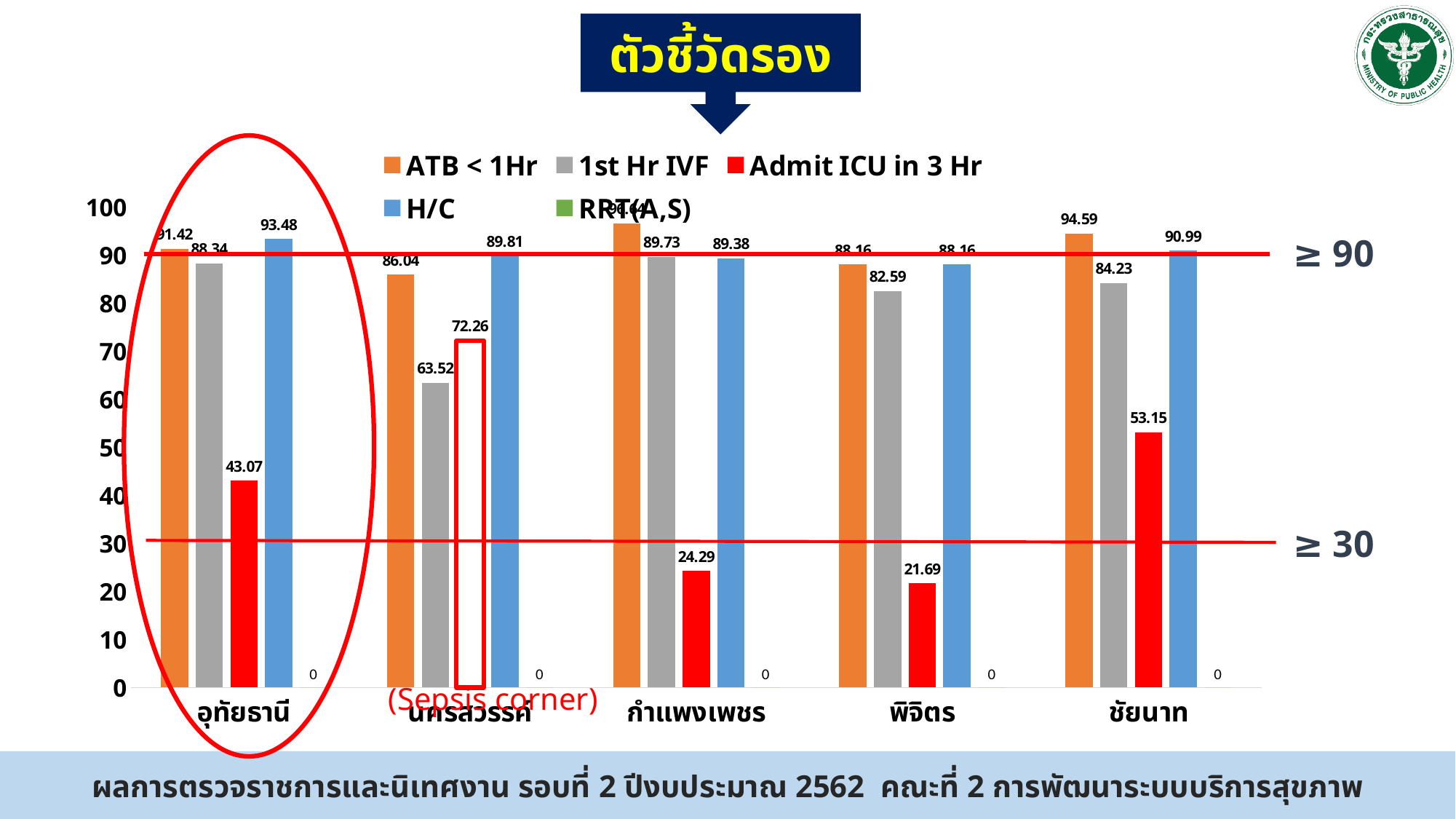
Is the Admit ICU in 3 Hr value for ชัยนาท greater or less than 50? greater What is the value of Admit ICU in 3 Hr for อุทัยธานี? 43.07 What is the RRT(A,S) value for พิจิตร? 0 Which province has the lowest Admit ICU in 3 Hr value? พิจิตร How many provinces are shown on the x axis? 5 How many series does the legend list? 5 What is the 1st Hr IVF value for นครสวรรค์? 63.52 Which province has the highest Admit ICU in 3 Hr value? นครสวรรค์ What is the difference between the H/C value and the 1st Hr IVF value for อุทัยธานี? 5.14 What type of chart is shown on the slide? bar chart Which is larger, the ATB < 1Hr value for ชัยนาท or for อุทัยธานี? ชัยนาท What is the H/C value for ชัยนาท? 90.99